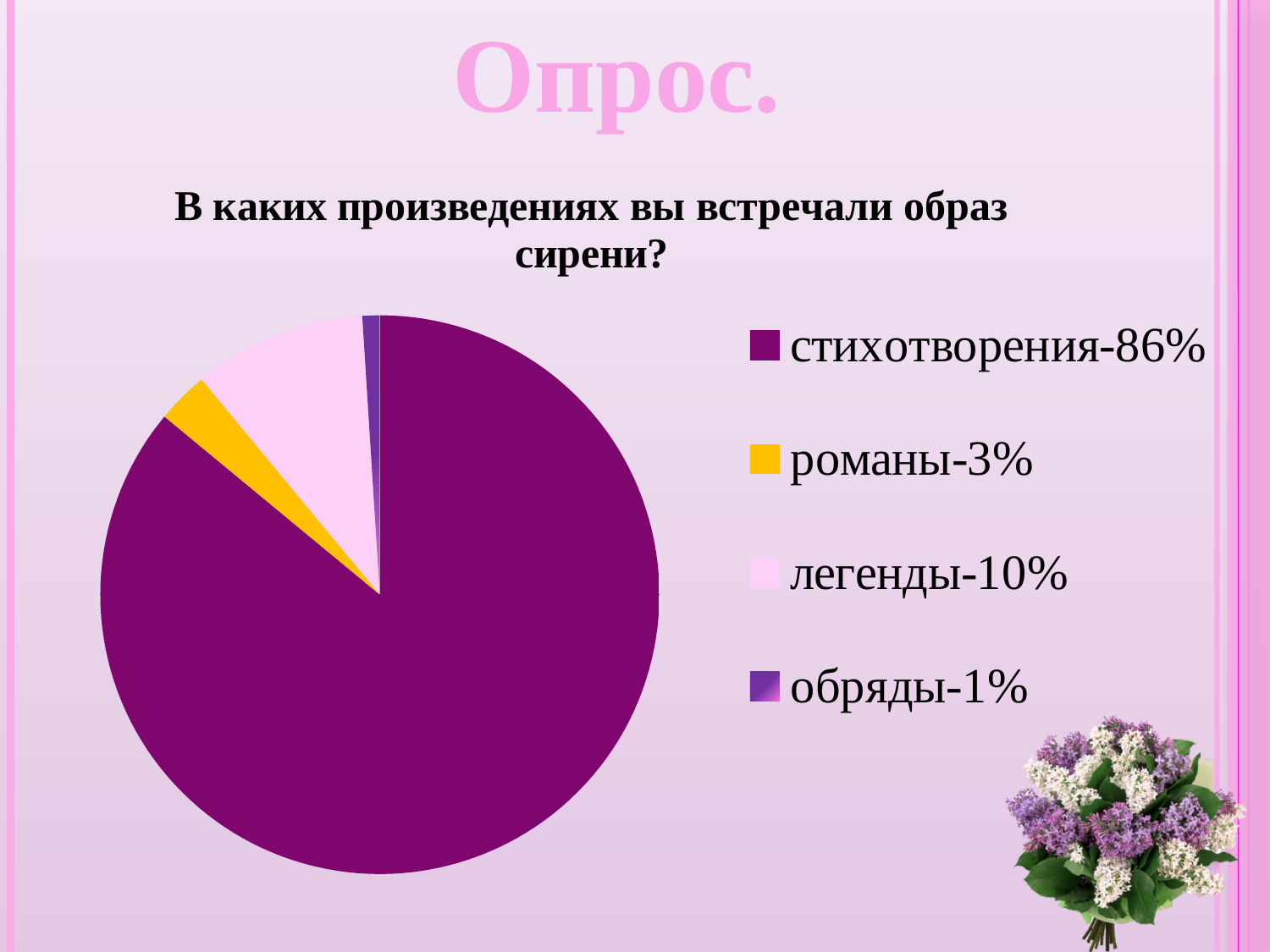
What is the chart's title? В каких произведениях вы встречали образ сирени? What share of the pie does стихотворения have? 86% What colour is the slice for романы? yellow What kind of chart is shown on the slide? pie chart What share of the pie does обряды have? 1% What share of the pie does романы have? 3% Which is larger, the share for романы or the share for легенды? легенды Which category has the largest slice of the pie? стихотворения Which category has the smallest slice of the pie? обряды How many categories does the pie chart have? 4 What is the difference between the shares for стихотворения and легенды? 76%